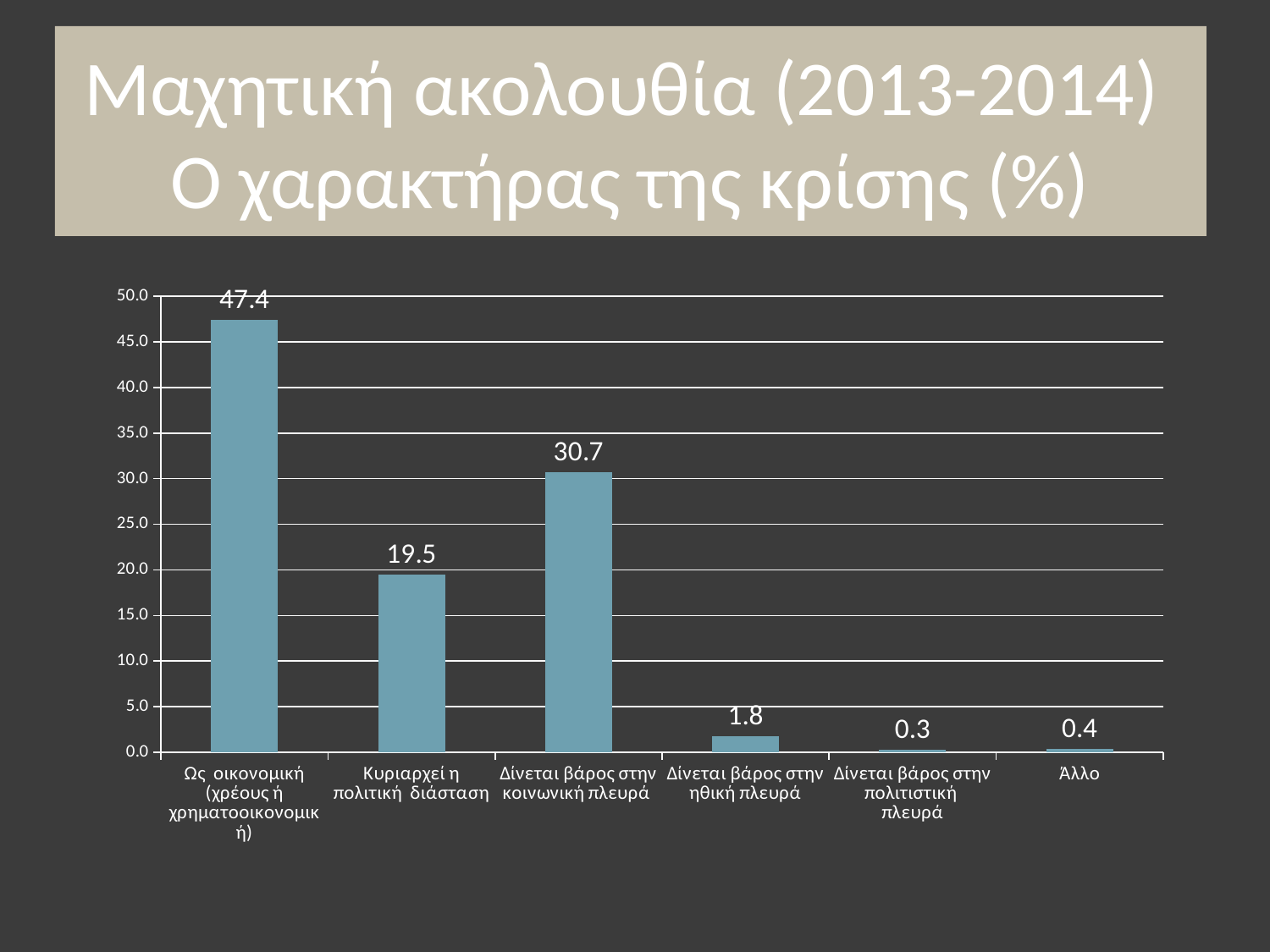
Which category has the lowest value? Δίνεται βάρος στην πολιτιστική πλευρά Which is larger: the value for 'Κυριαρχεί η πολιτική διάσταση' or for 'Δίνεται βάρος στην κοινωνική πλευρά'? Δίνεται βάρος στην κοινωνική πλευρά What kind of chart is shown on the slide? Bar chart What is the difference between the values for 'Ως οικονομική (χρέους ή χρηματοοικονομική)' and 'Δίνεται βάρος στην κοινωνική πλευρά'? 16.7 How many categories are shown in the chart? 6 What is the value for 'Δίνεται βάρος στην ηθική πλευρά'? 1.8 What is the value for 'Άλλο'? 0.4 What is the value for 'Κυριαρχεί η πολιτική διάσταση'? 19.5 What is the value for 'Δίνεται βάρος στην κοινωνική πλευρά'? 30.7 Which category has the highest value? Ως οικονομική (χρέους ή χρηματοοικονομική) What is the value for 'Ως οικονομική (χρέους ή χρηματοοικονομική)'? 47.4 What is the title of the slide? Μαχητική ακολουθία (2013-2014) Ο χαρακτήρας της κρίσης (%)